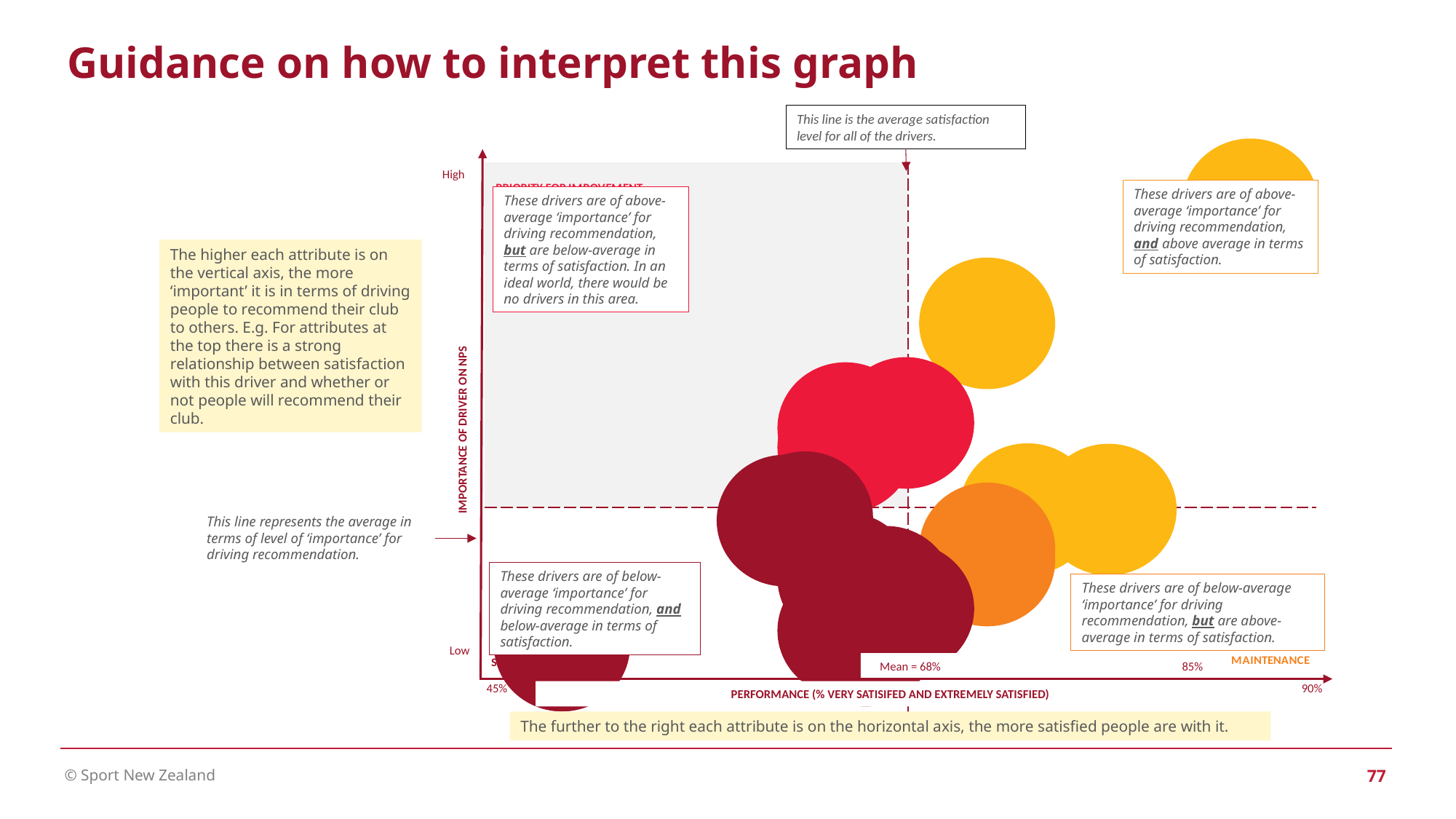
What is the highest value labelled on the horizontal axis of the chart? 90% What is the title of the vertical axis of the chart? IMPORTANCE OF DRIVER ON NPS What is the title of the horizontal axis of the chart? PERFORMANCE (% VERY SATISIFED AND EXTREMELY SATISFIED) What mean value is printed on the horizontal axis of the chart? Mean = 68% What is the lowest value labelled on the horizontal axis of the chart? 45% What kind of chart is shown on the slide? Bubble chart